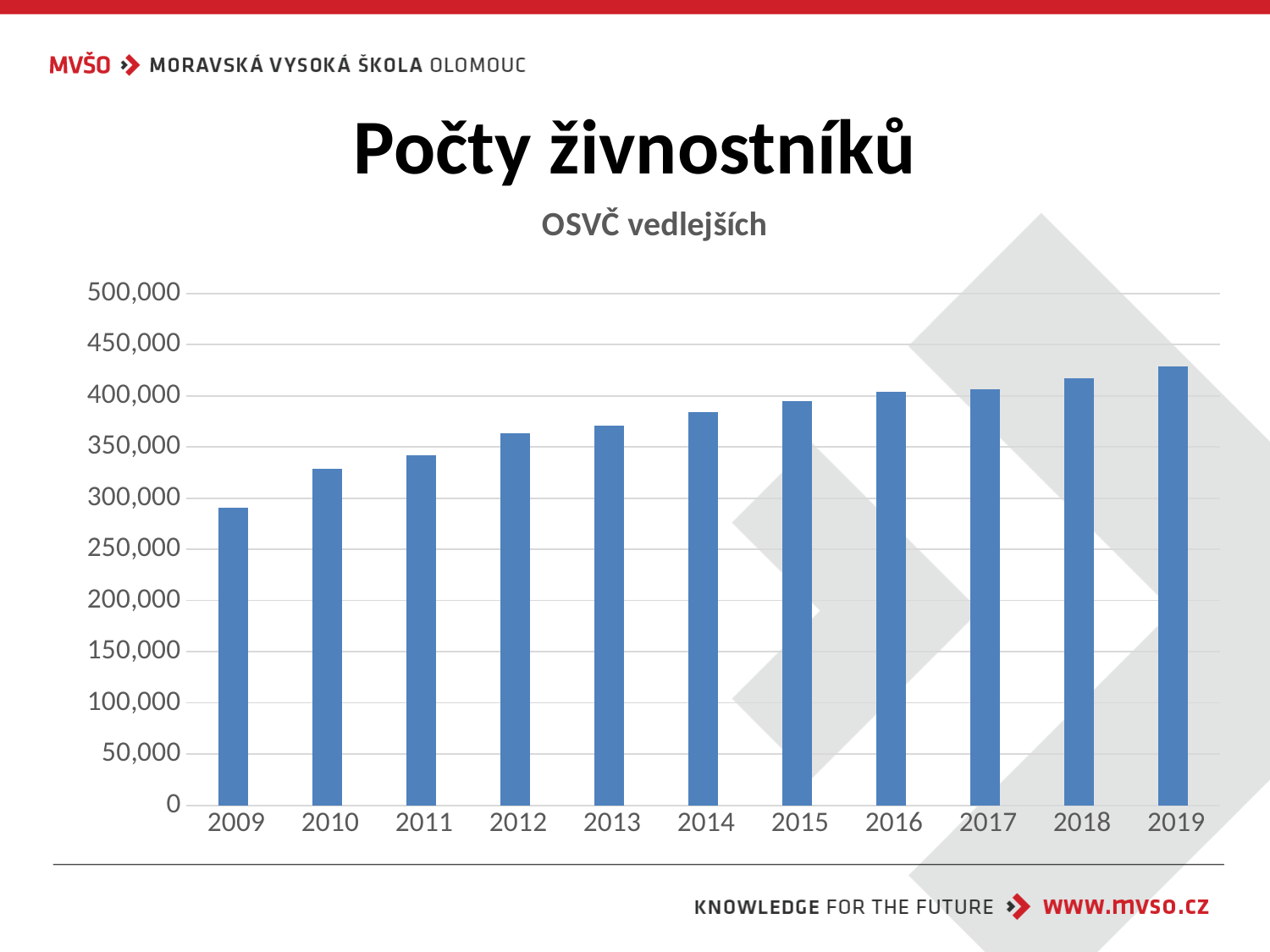
Which year has the highest value in the chart? 2019 Is the value for 2012 greater or less than 350,000? greater What is the title of the chart? OSVČ vedlejších Is the value for 2015 greater or less than 400,000? less Is the value for 2019 greater or less than 400,000? greater What colour are the bars in the chart? blue Which year has the lowest value in the chart? 2009 How many years are shown on the x axis of the chart? 11 Which is larger, the value for 2010 or the value for 2014? 2014 Do the values generally rise or fall from 2009 to 2019? rise What kind of chart is shown on the slide? bar chart